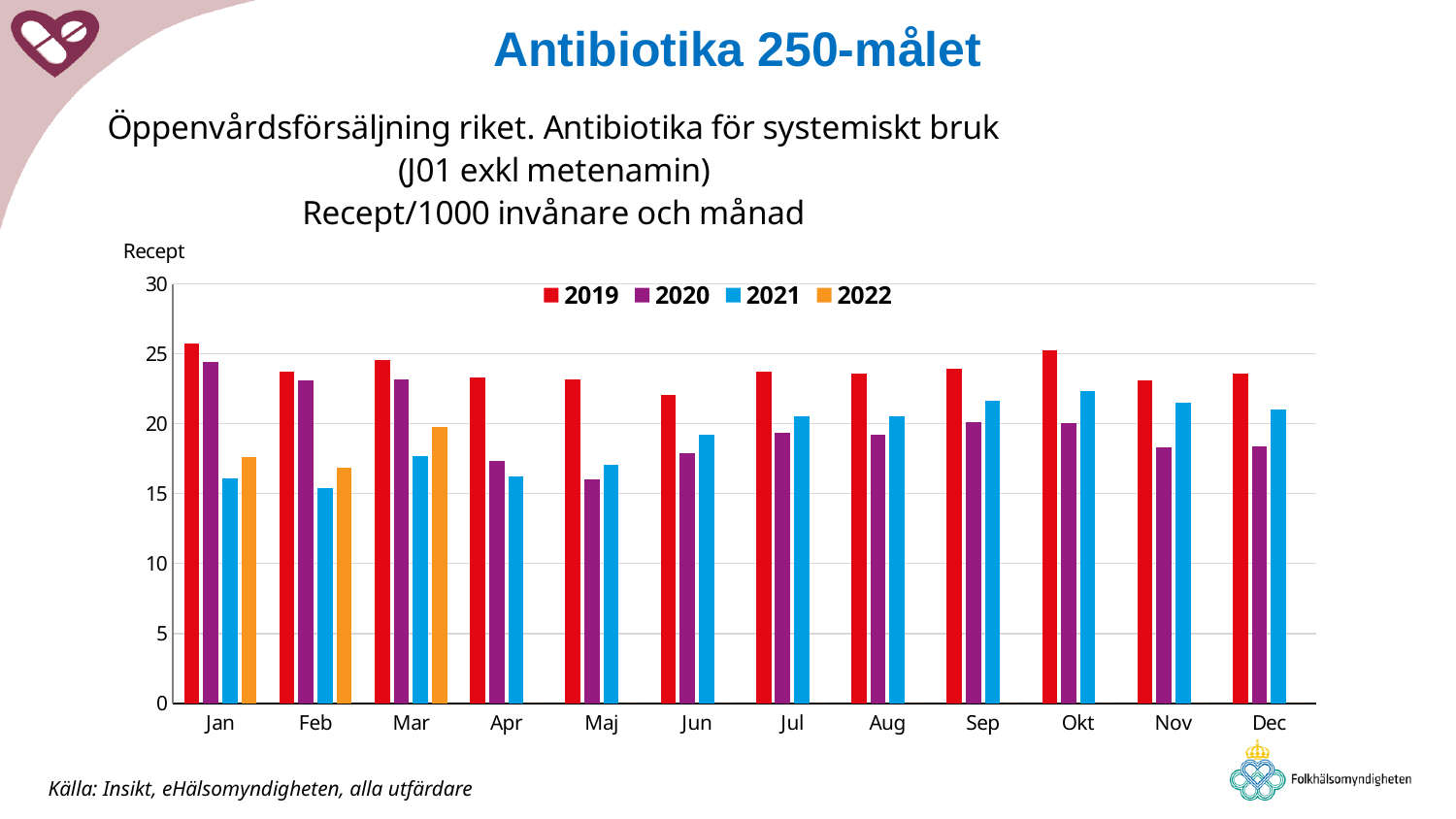
How many series does the legend list? 4 Is the value for 2019 in Jan greater or less than 20? greater How many months are shown along the x axis? 12 Which year has the highest bar in Jan? 2019 Which month has the lowest 2020 bar? Maj In Okt, which is larger, the 2020 value or the 2021 value? 2021 What kind of chart is shown on the slide? bar chart Which colour represents the 2022 series in the legend? orange Is the value for 2021 in Feb greater or less than 20? less Is the value for 2022 in Mar greater or less than 15? greater For how many months is a 2022 bar plotted? 3 In Jan, which is larger, the 2021 value or the 2022 value? 2022